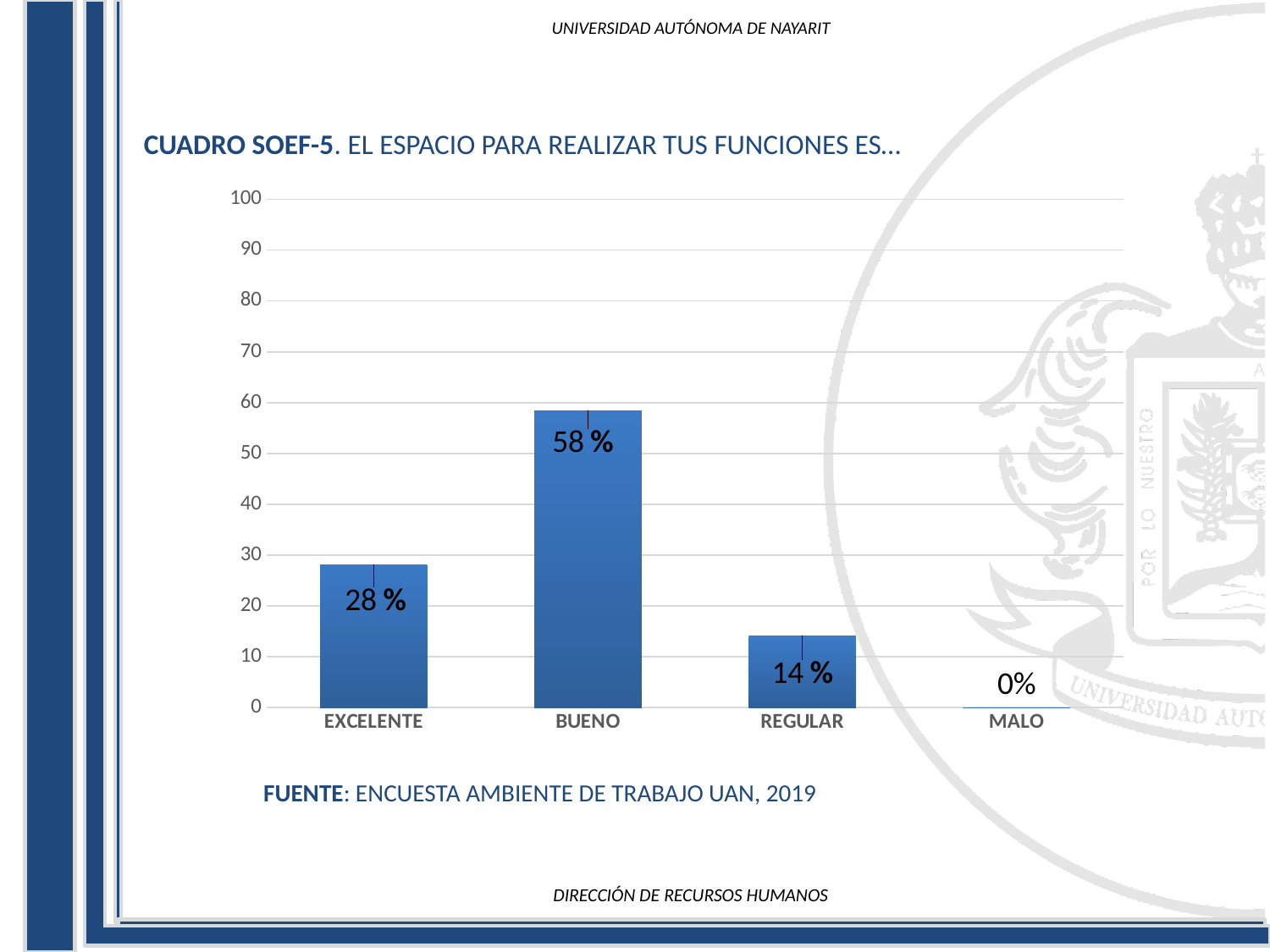
What is the difference between the values for BUENO and EXCELENTE? 30 % Which is larger, the value for EXCELENTE or the value for REGULAR? EXCELENTE Which category has the lowest value? MALO Is the value for BUENO greater or less than 50? greater What is the value for REGULAR? 14 % What is the value for EXCELENTE? 28 % What is the value for MALO? 0% How many categories are shown on the x axis? 4 What is the source cited below the chart? ENCUESTA AMBIENTE DE TRABAJO UAN, 2019 What kind of chart is shown on the slide? bar chart Which category has the highest value? BUENO What is the value for BUENO? 58 %